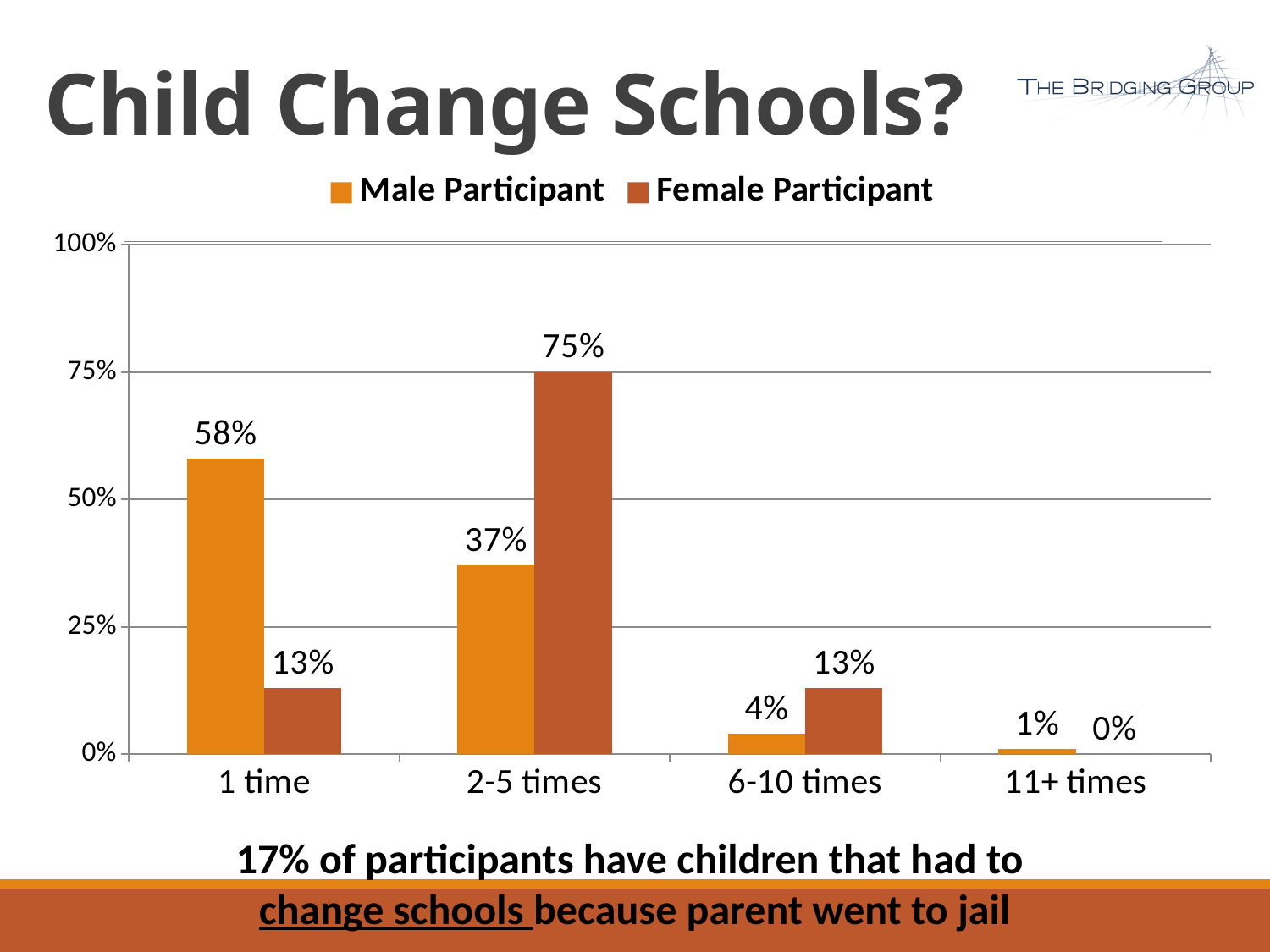
Which category has the lowest value for Male Participant? 11+ times What is the value for Male Participant in the 1 time category? 58% How many categories are shown on the x axis? 4 How many series does the legend list? 2 In the 1 time category, which is larger: Male Participant or Female Participant? Male Participant What is the value for Female Participant in the 11+ times category? 0% What is the difference between the Female Participant and Male Participant values in the 2-5 times category? 38% What is the value for Female Participant in the 2-5 times category? 75% Which colour represents Male Participant in the legend? Orange What kind of chart is shown on the slide? Bar chart Which category has the highest value for Female Participant? 2-5 times What is the value for Male Participant in the 6-10 times category? 4%